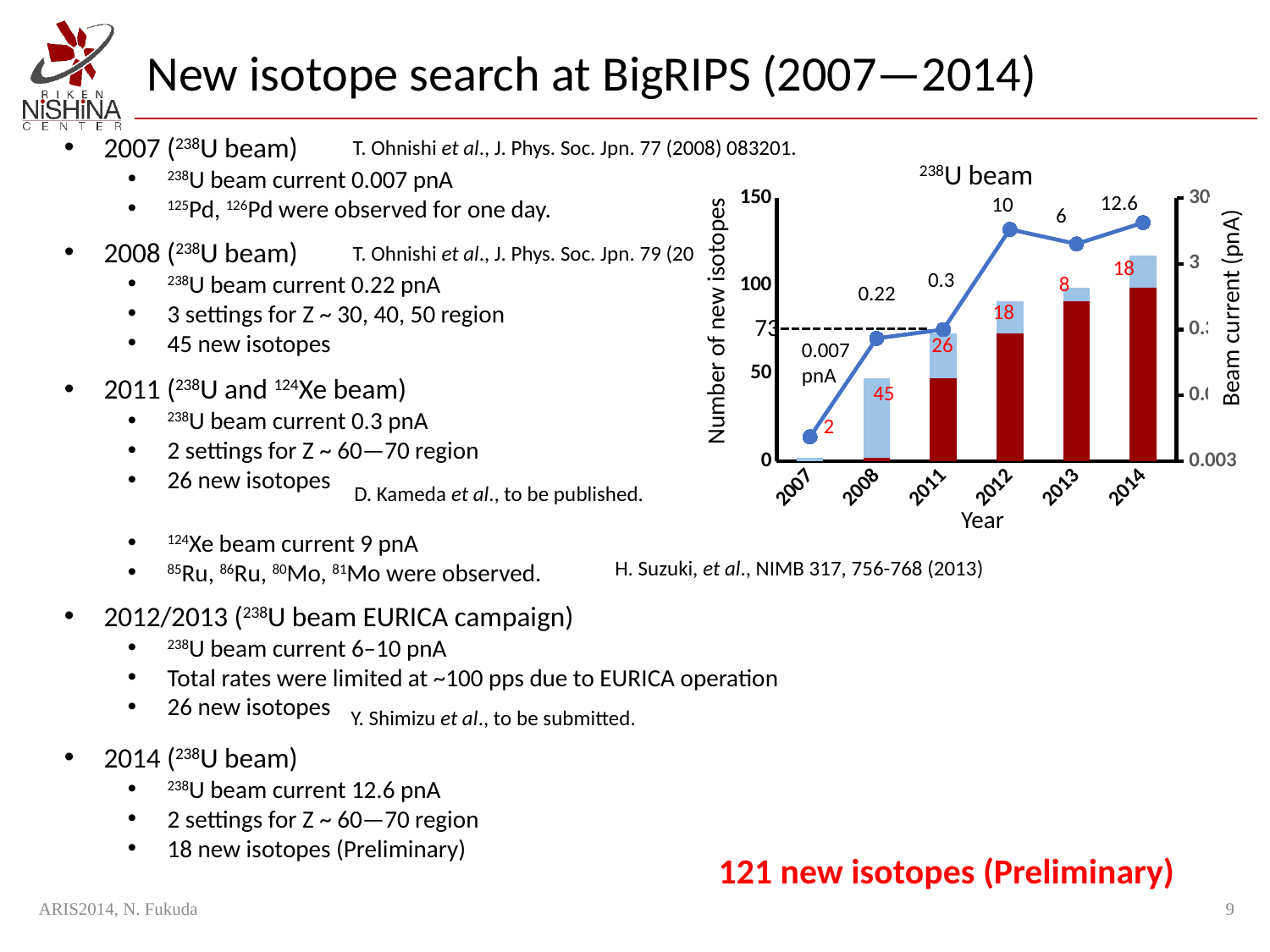
How many new isotopes are labelled on the bar for 2008? 45 What kind of chart is used to show the number of new isotopes? Stacked bar chart with a line overlay What beam current is labelled for 2007 on the chart? 0.007 pnA How many years are shown on the x axis? 6 Which is larger, the beam current for 2012 or for 2013? 2012 Which year has the lowest beam current on the line? 2007 What is the 238U beam current plotted for 2014? 12.6 Which year has the highest beam current on the line? 2014 What is the difference between the new isotopes labelled for 2008 and 2011? 19 How many new isotopes are labelled on the bar for 2011? 26 What is the title of the chart? 238U beam Which year has the largest labelled number of new isotopes? 2008